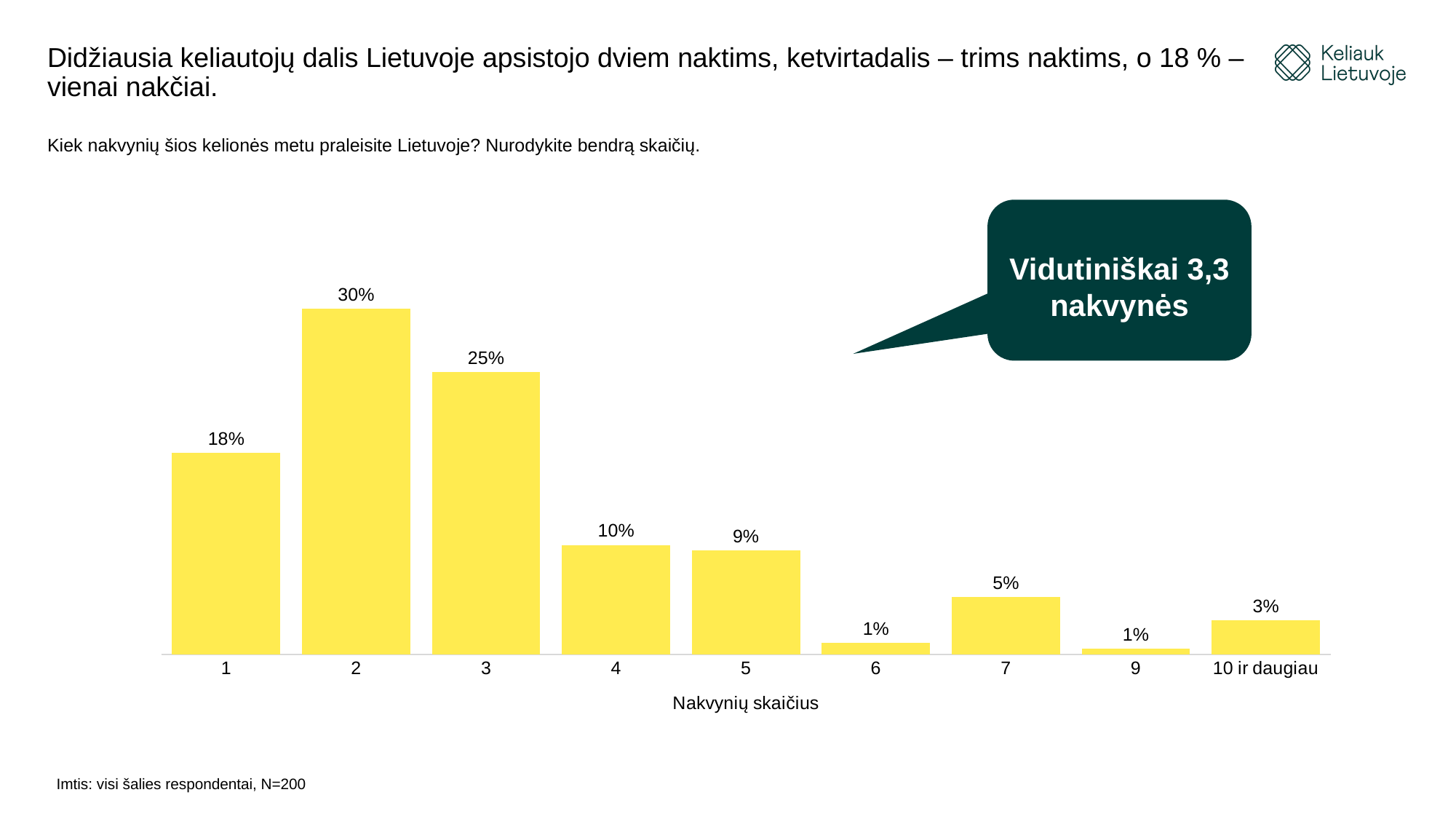
What average number of nights is stated in the callout box? 3,3 How many categories are shown on the x axis? 9 Which is larger, the value for 6 nights or the value for 7 nights? 7 nights What is the x-axis title of the chart? Nakvynių skaičius What is the difference between the values for 2 nights and 3 nights? 5% What is the value shown for 1 night? 18% Which number of nights has the highest share of travellers? 2 What percentage is shown for the '10 ir daugiau' category? 3% Which is larger, the value for 4 nights or the value for 5 nights? 4 nights What kind of chart is shown on the slide? Bar chart What is the difference between the values for 1 night and 7 nights? 13% What percentage of travellers stayed 2 nights? 30%